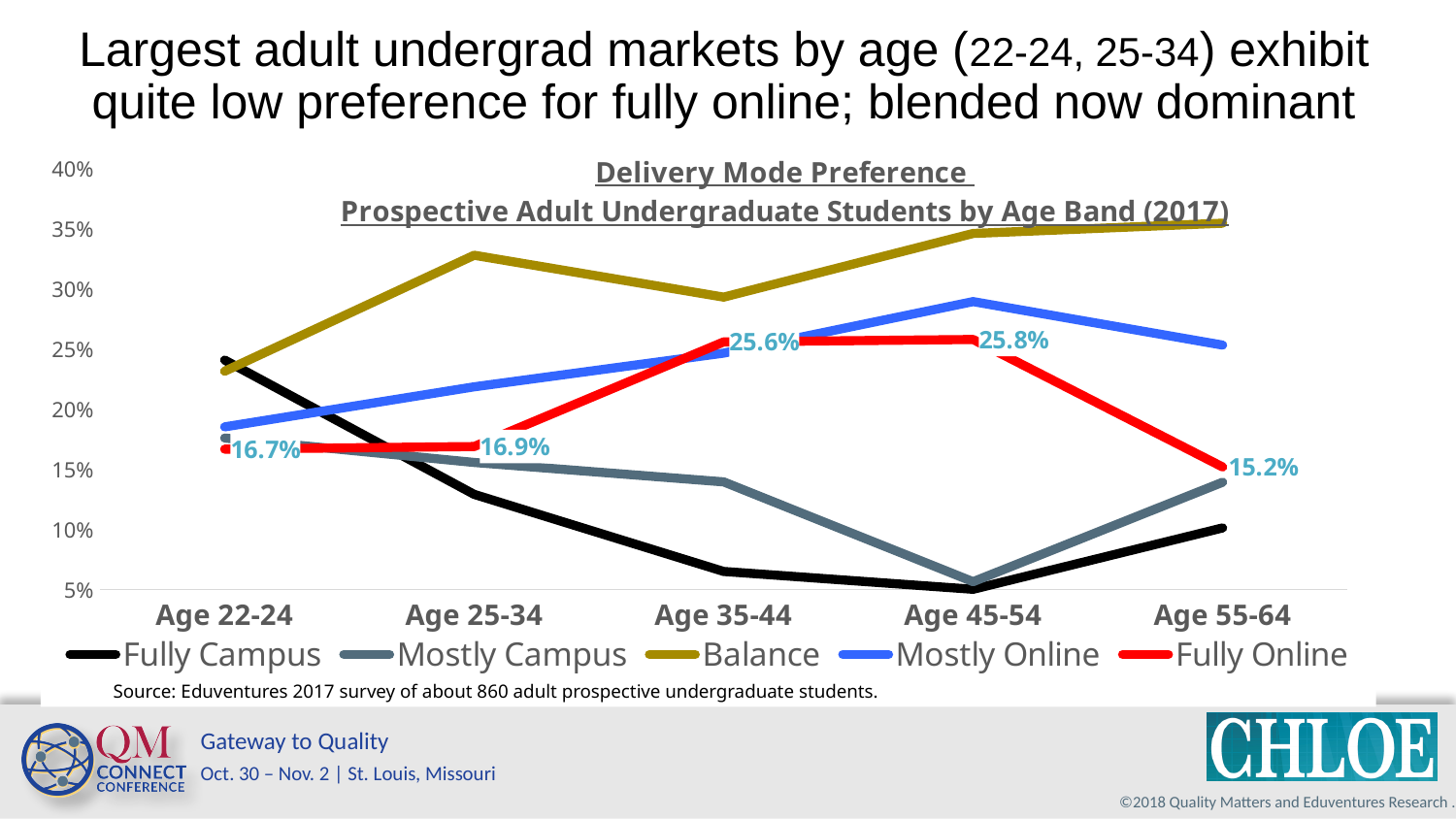
Which age band has the lowest Fully Online value? Age 55-64 What is the Fully Online value for Age 55-64? 15.2% What is the difference between the Fully Online values for Age 45-54 and Age 55-64? 10.6 percentage points What kind of chart is shown on the slide? line chart Is the Fully Campus value for Age 45-54 greater or less than 10%? less Does the Fully Campus line rise or fall from Age 22-24 to Age 45-54? fall What is the Fully Online value for Age 45-54? 25.8% How many age bands are shown on the x axis? 5 Which is larger, the Fully Online value for Age 35-44 or for Age 22-24? Age 35-44 Is the Balance value for Age 25-34 greater or less than 30%? greater What is the Fully Online value for Age 22-24? 16.7% How many series does the legend list? 5